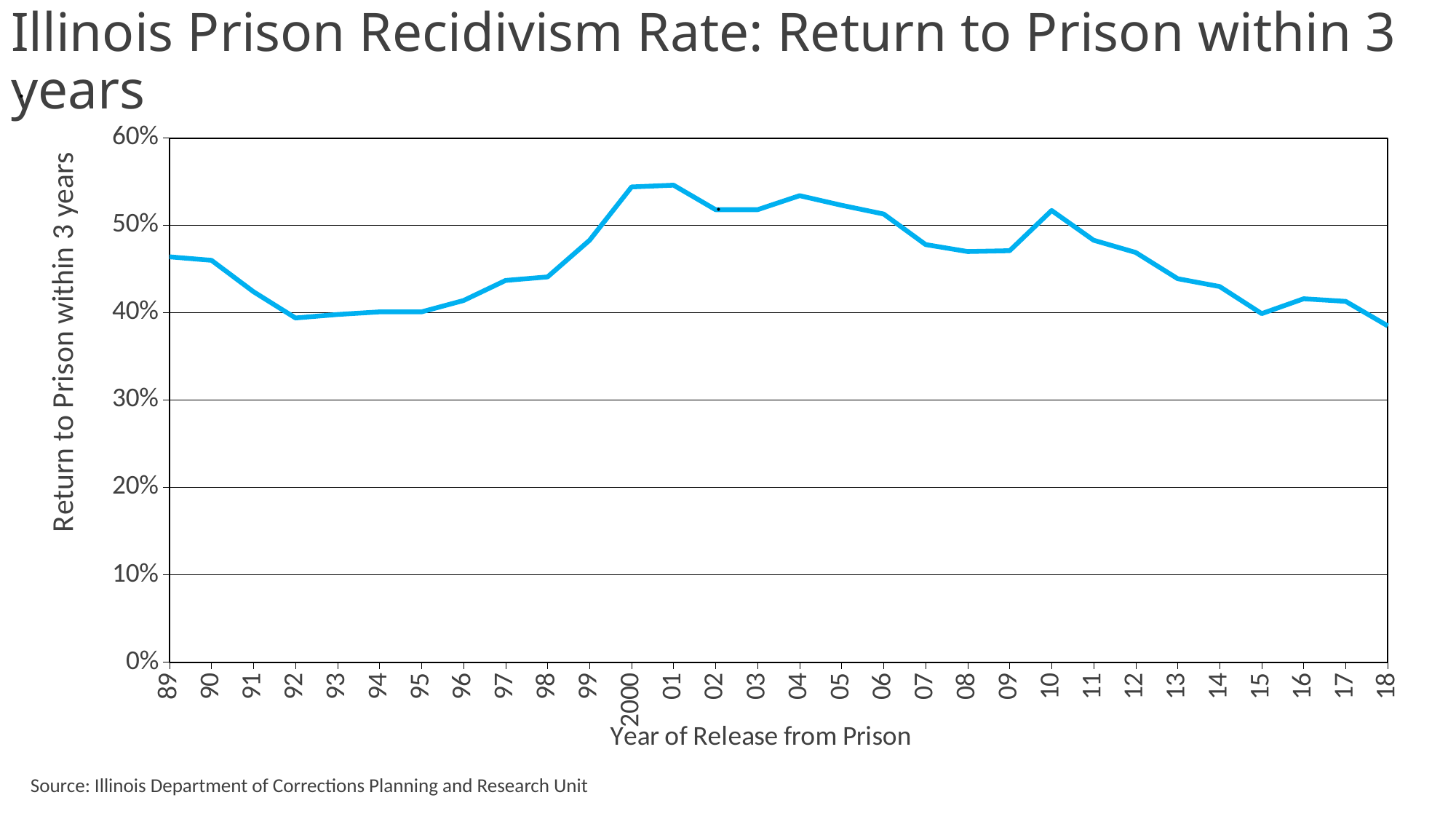
How many years of release are plotted along the x axis? 30 What kind of chart is shown on the slide? line chart Is the value for 94 greater or less than 50%? less Is the value for 2000 greater or less than 50%? greater Which has the higher recidivism rate, 10 or 13? 10 Which has the higher recidivism rate, 2000 or 95? 2000 Is the value for 13 greater or less than 50%? less Which has the higher recidivism rate, 89 or 92? 89 Does the recidivism rate rise or fall from 95 to 2000? rise What is the title of the x axis? Year of Release from Prison Does the recidivism rate rise or fall from 10 to 15? fall